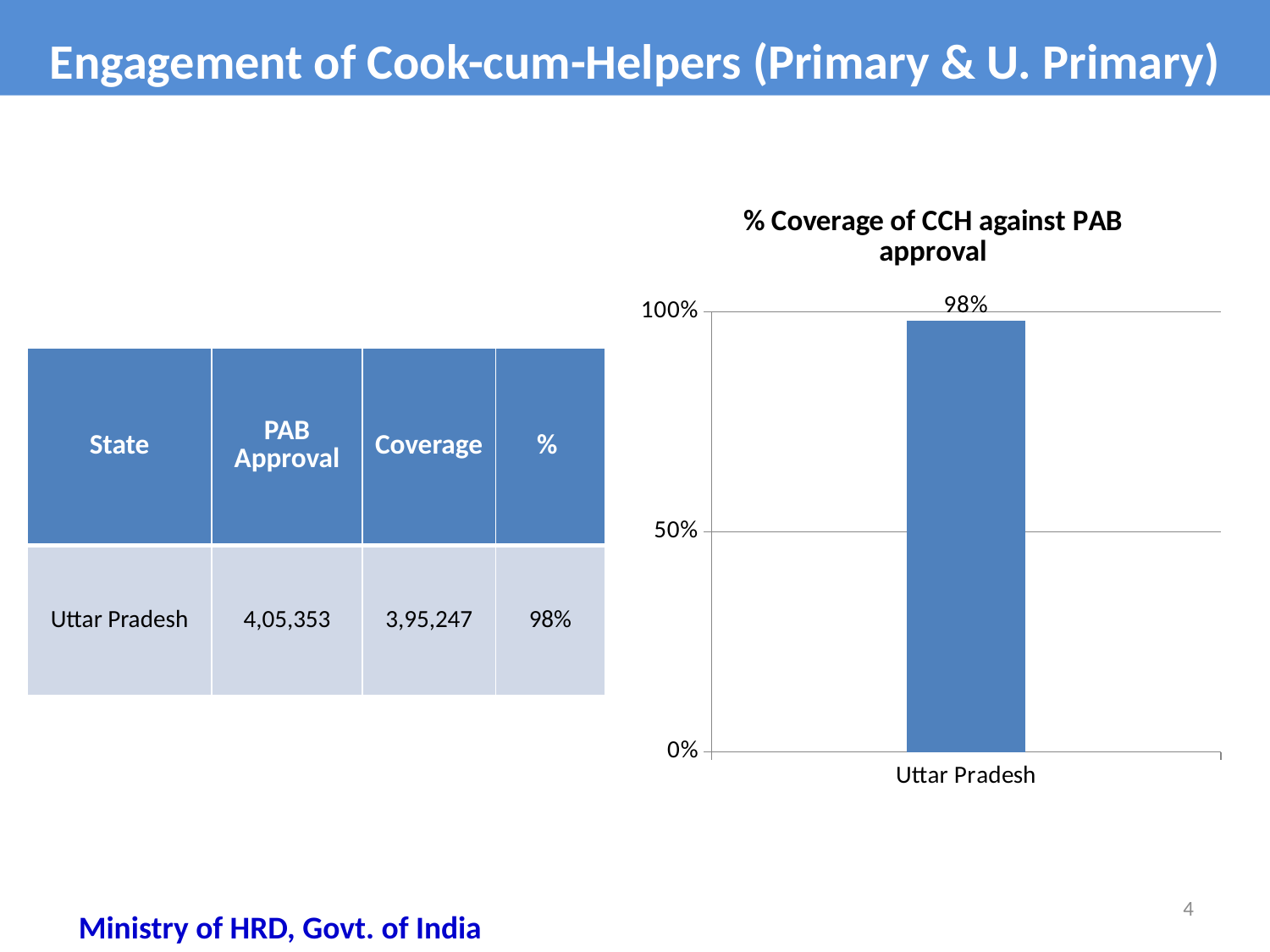
What is the title of the chart? % Coverage of CCH against PAB approval Which state is shown on the x axis of the chart? Uttar Pradesh What is the highest value shown on the chart's y axis? 100% Is the value for Uttar Pradesh greater or less than 50%? greater What kind of chart is shown on the slide? bar chart What is the value for Uttar Pradesh in the chart? 98% How many categories are plotted in the chart? 1